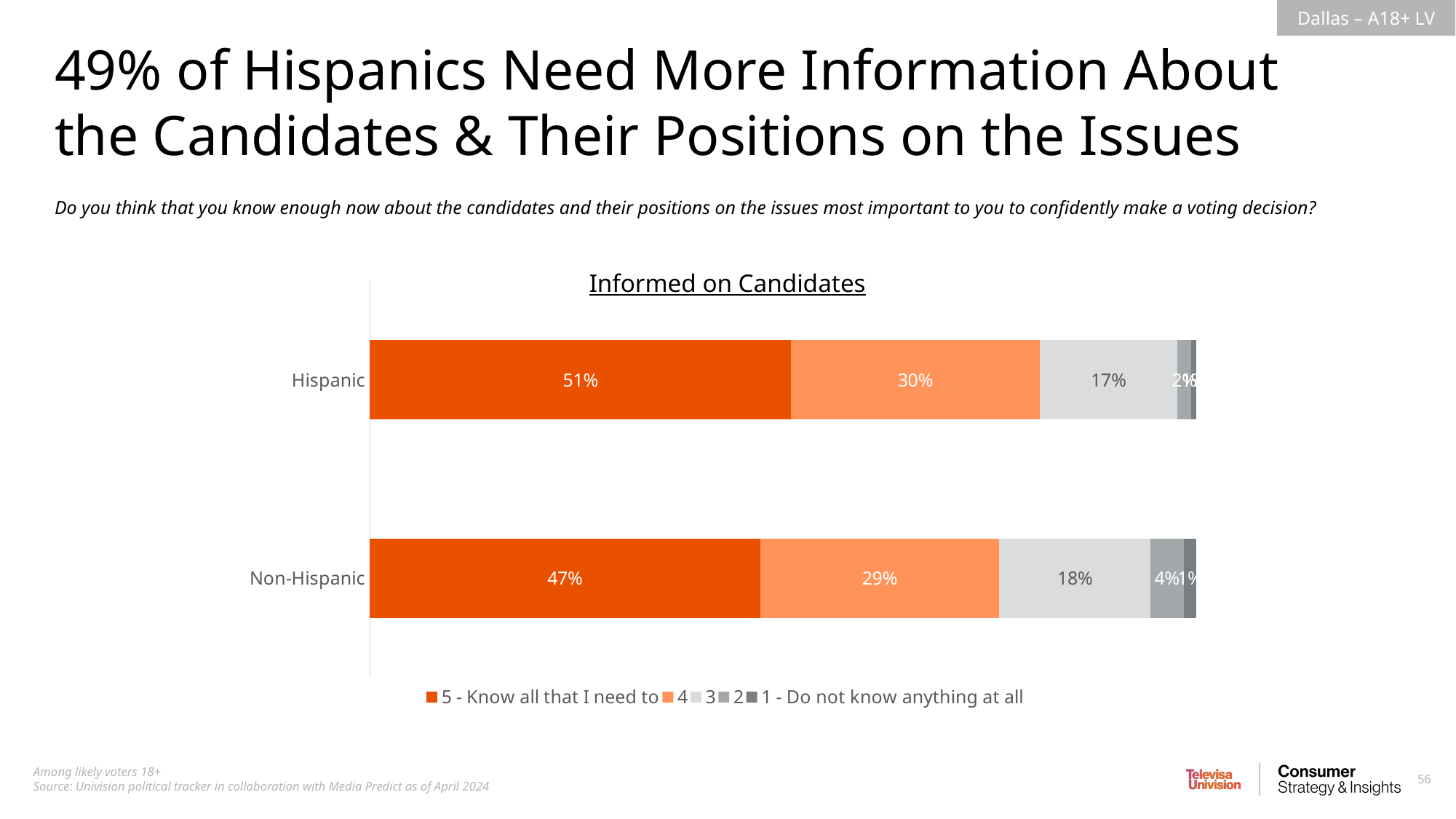
How many groups (bars) are shown in the chart? 2 What is the value for the "4" rating among Hispanic respondents? 30% What is the value for the "2" rating among Non-Hispanic respondents? 4% What is the value for "1 - Do not know anything at all" among Non-Hispanic respondents? 1% What is the value for the "3" rating among Non-Hispanic respondents? 18% How many series does the legend list? 5 What percentage of Hispanic respondents answered "5 - Know all that I need to"? 51% What percentage of Non-Hispanic respondents answered "5 - Know all that I need to"? 47% How many percentage points higher is the "5 - Know all that I need to" share for Hispanic respondents than for Non-Hispanic respondents? 4 percentage points What type of chart is shown on the slide? Stacked bar chart Which group has the larger share for the "3" rating, Hispanic or Non-Hispanic? Non-Hispanic Which group has the larger share for the "4" rating, Hispanic or Non-Hispanic? Hispanic